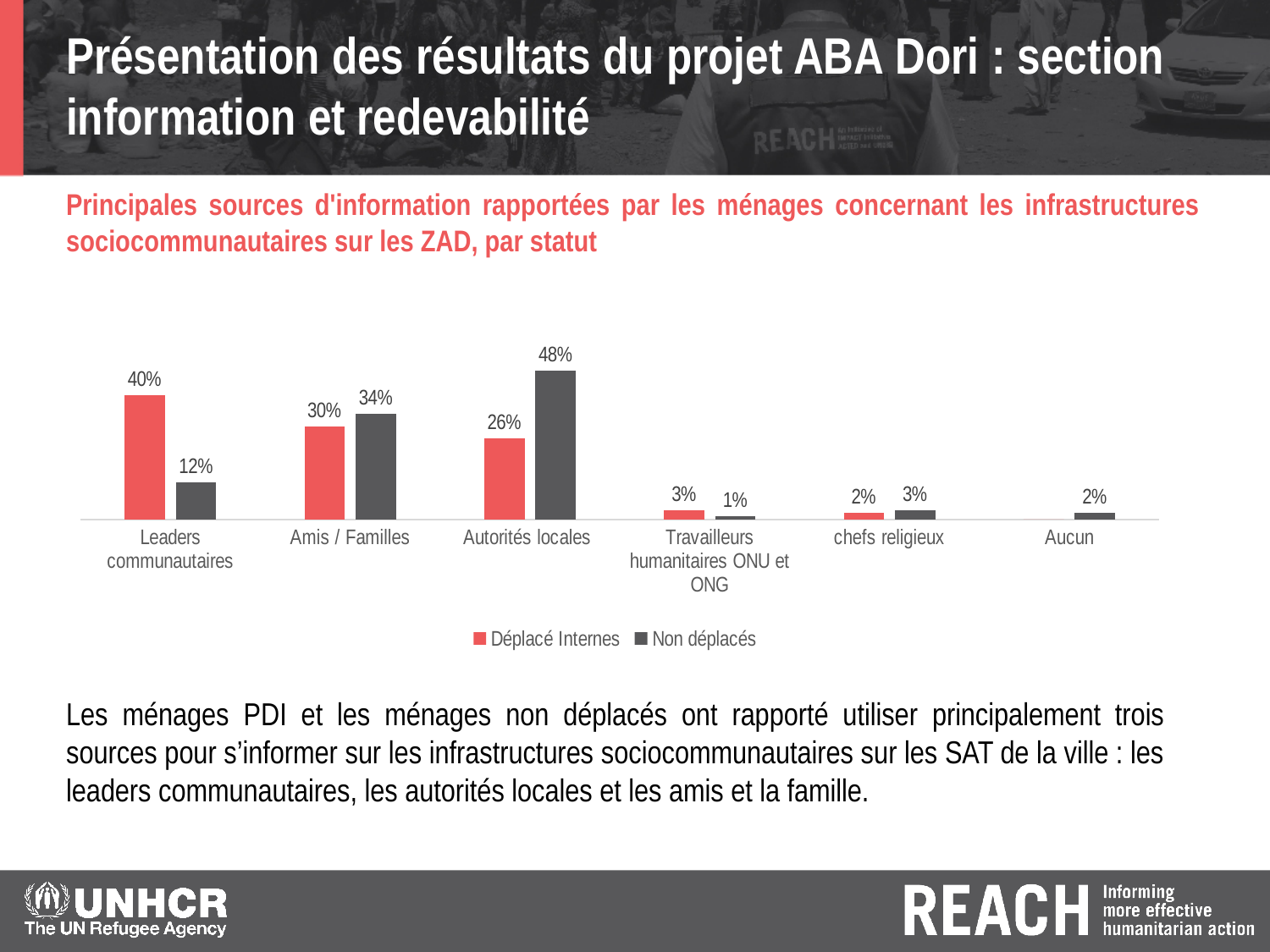
What is the value for Non déplacés in the Aucun category? 2% What is the value for Déplacé Internes in the Leaders communautaires category? 40% What is the difference between the Non déplacés and Déplacé Internes values for Autorités locales? 22% Which series is shown in red in the legend? Déplacé Internes How many series does the legend list? 2 What is the value for Non déplacés in the Autorités locales category? 48% What kind of chart is shown on the slide? Bar chart What is the value for Non déplacés in the Leaders communautaires category? 12% Which category has the highest value for Déplacé Internes? Leaders communautaires How many categories are shown on the x axis? 6 Which category has the lowest value for Non déplacés? Travailleurs humanitaires ONU et ONG Which is larger for Amis / Familles: the Déplacé Internes value or the Non déplacés value? Non déplacés